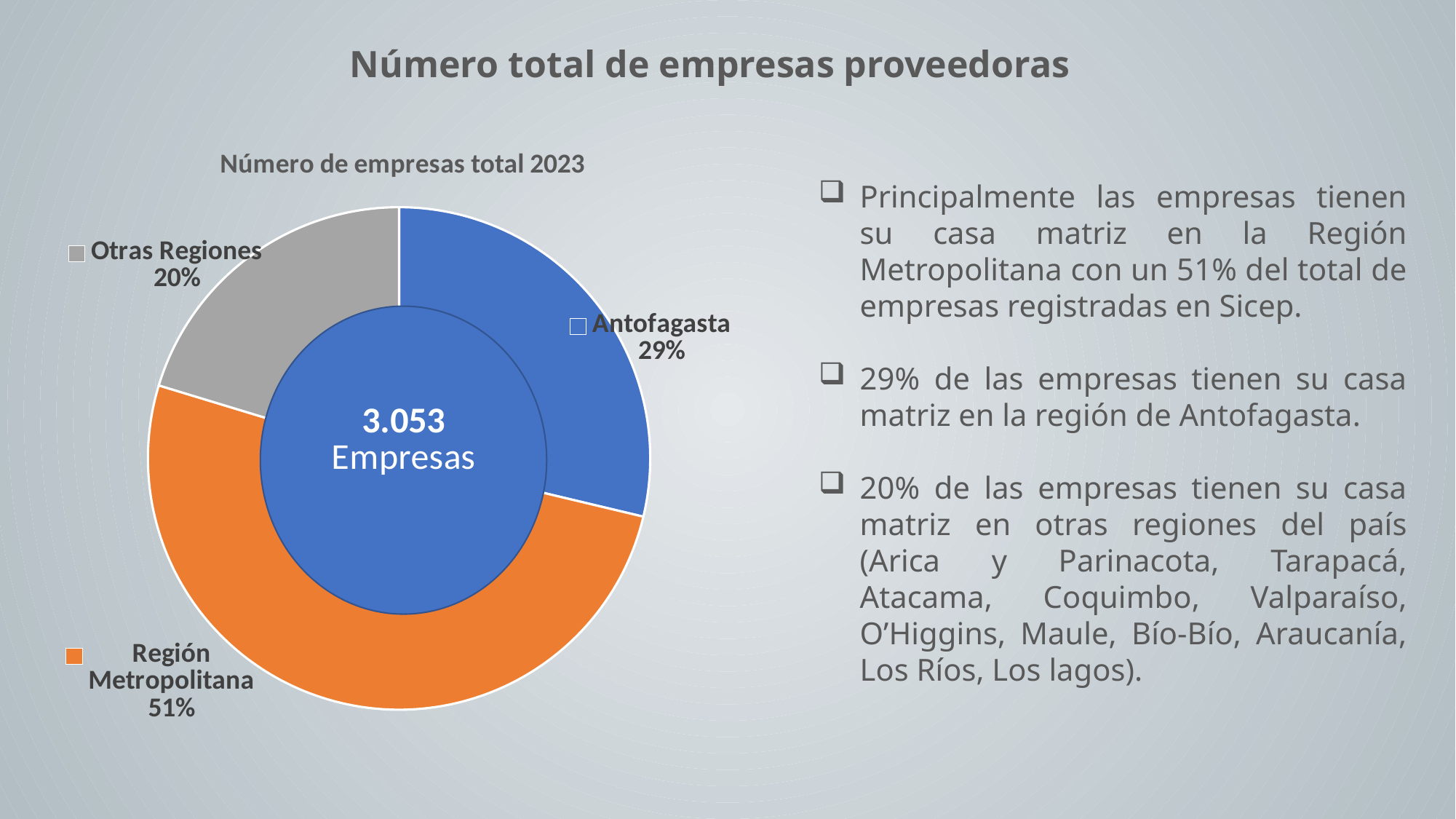
Which is larger, the share for Antofagasta or the share for Otras Regiones? Antofagasta Which category has the largest share of the pie? Región Metropolitana What total number of companies is shown in the centre of the chart? 3.053 Empresas What kind of chart is shown on the slide? Doughnut chart What share of the pie does Región Metropolitana hold? 51% What share of the pie does Otras Regiones hold? 20% What is the difference in percentage points between Antofagasta and Otras Regiones? 9 What is the title of the chart? Número de empresas total 2023 What share of the pie does Antofagasta hold? 29% Which category has the smallest share of the pie? Otras Regiones What is the difference in percentage points between Región Metropolitana and Antofagasta? 22 How many categories does the pie chart show? 3